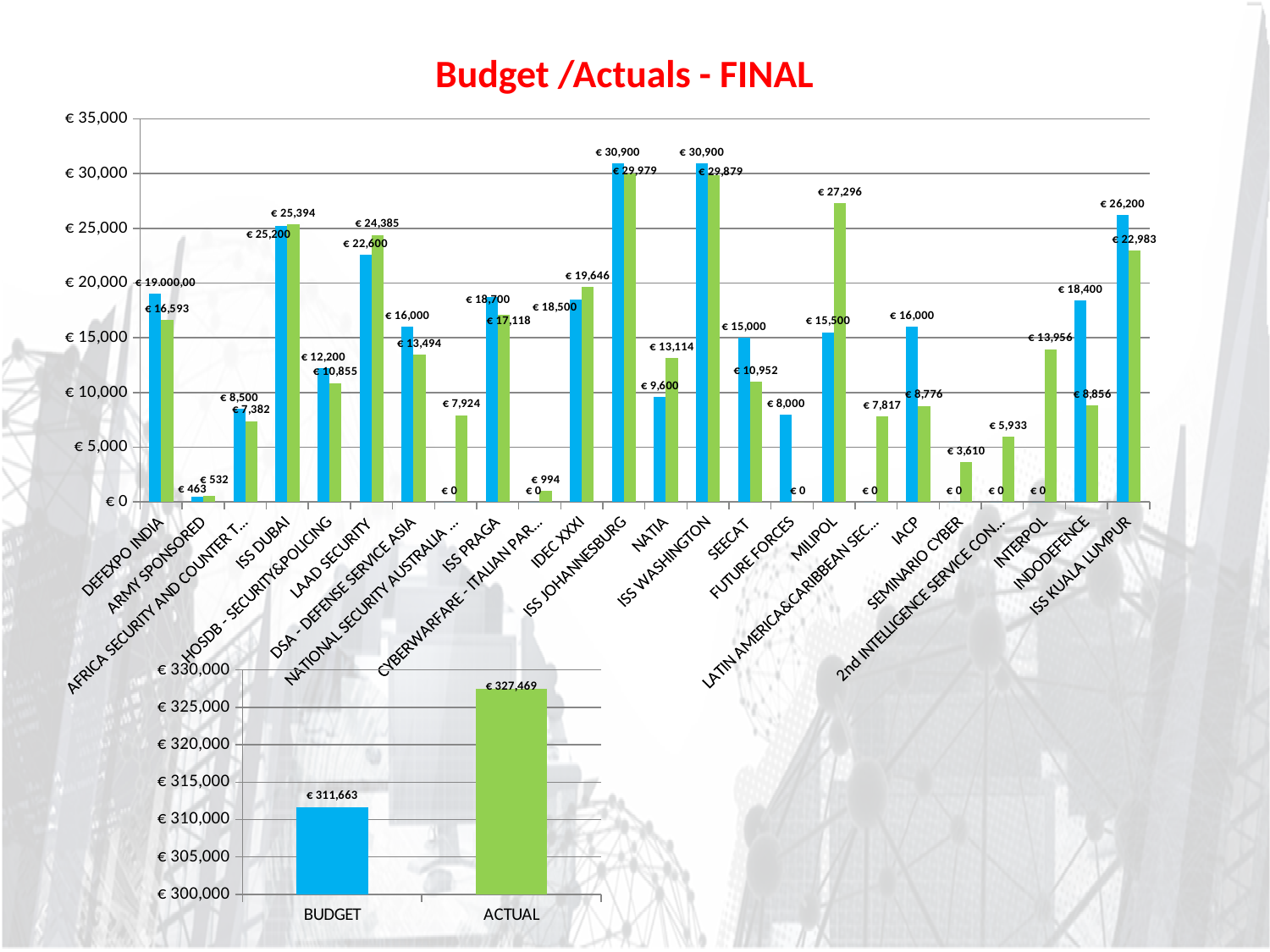
In the top chart, which category has the lowest green (actual) bar? FUTURE FORCES In the top chart, what is the difference between the blue (budget) and green (actual) bars for IACP? € 7,224 In the bottom chart, what is the difference between the ACTUAL and BUDGET values? € 15,806 In the bottom chart, what is the value of the ACTUAL bar? € 327,469 In the top chart, what is the value of the blue (budget) bar for ISS KUALA LUMPUR? € 26,200 What kind of chart is the top chart? Bar chart How many categories are shown on the x axis of the top chart? 24 In the top chart, what is the value of the green (actual) bar for MILIPOL? € 27,296 In the bottom chart, what is the value of the BUDGET bar? € 311,663 In the bottom chart, which bar is larger, BUDGET or ACTUAL? ACTUAL What is the title of the slide's main chart? Budget /Actuals - FINAL In the top chart, is the green (actual) bar for INTERPOL greater or less than € 10,000? greater